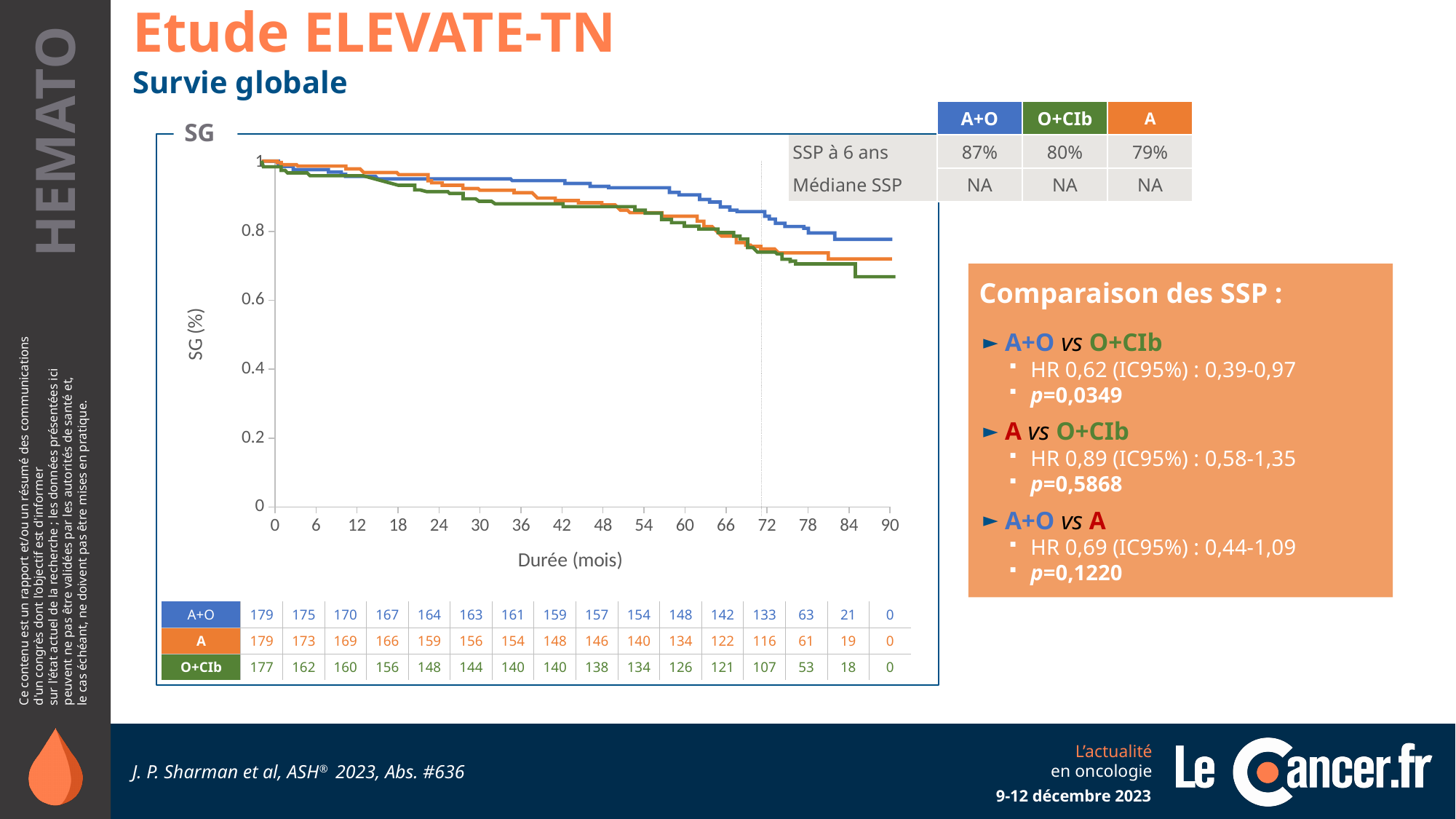
Do the survival curves on the SG chart rise or fall as the duration in months increases? Fall What kind of chart is shown under the title "SG"? Line chart (Kaplan-Meier survival curve) At 90 months, which group's curve is the lowest on the SG chart? O+CIb In the number-at-risk table below the SG chart, how many patients are at risk in the A+O group at 0 months? 179 Is the value of the A+O curve at 48 months greater or less than 0.8? greater According to the table at the top right, what is the SSP à 6 ans for the A+O group? 87% In the number-at-risk table below the SG chart, how many patients are at risk in the O+CIb group at 72 months? 107 What is the label of the x axis of the SG chart? Durée (mois) How many treatment groups (series) are plotted on the SG chart? 3 At 90 months, which group's curve is the highest on the SG chart? A+O What is the difference between the number at risk at 0 months for A+O (179) and for O+CIb (177)? 2 Is the value of the O+CIb curve at 90 months greater or less than 0.8? less